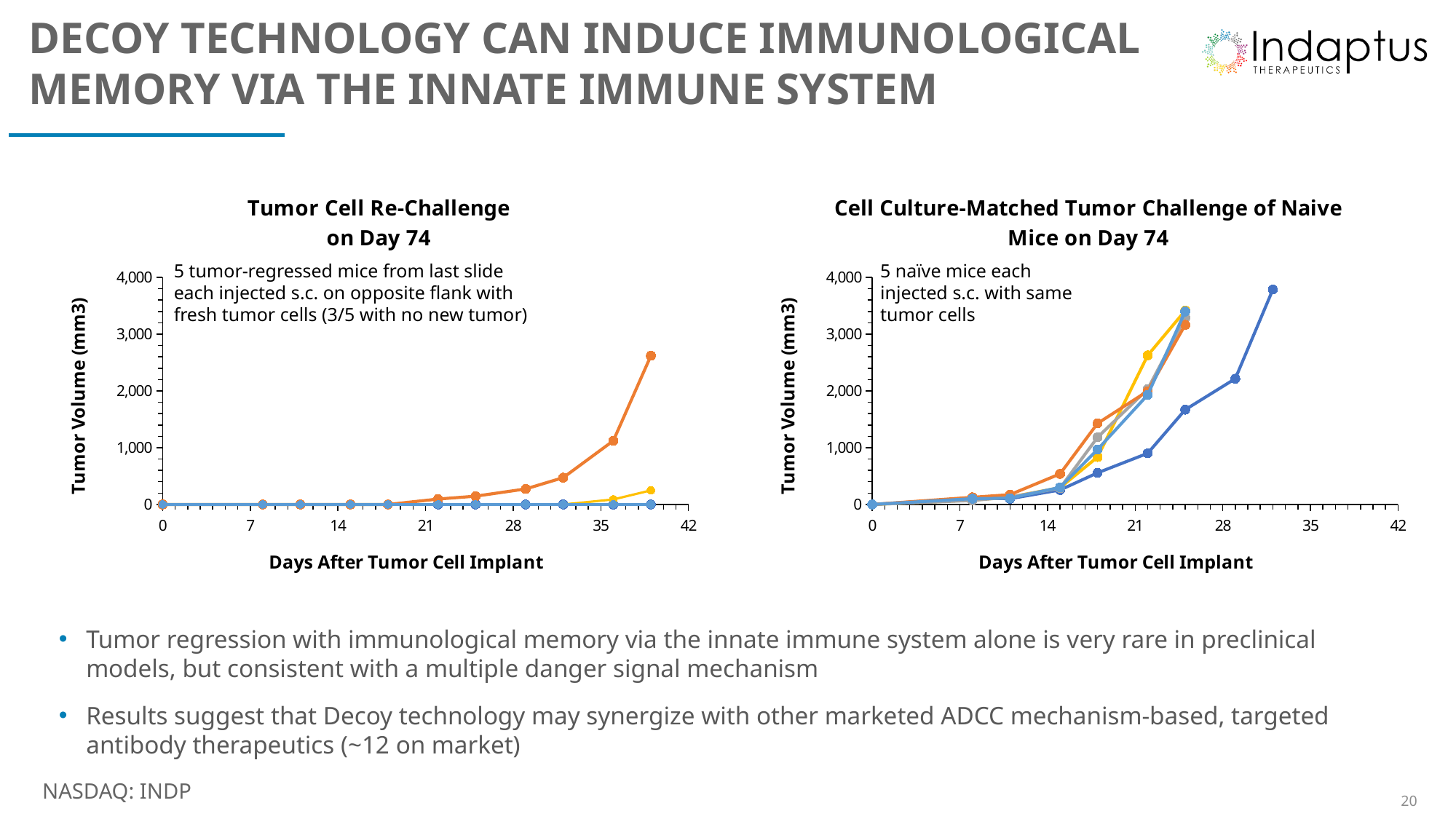
In the 'Tumor Cell Re-Challenge on Day 74' chart, which line has the larger final value, the orange line or the yellow line? orange In the 'Cell Culture-Matched Tumor Challenge of Naive Mice on Day 74' chart, are all the lines greater or less than 1,000 at day 14? less What kind of chart is the 'Cell Culture-Matched Tumor Challenge of Naive Mice on Day 74' chart? line chart In the 'Cell Culture-Matched Tumor Challenge of Naive Mice on Day 74' chart, what is the label of the x axis? Days After Tumor Cell Implant What is the highest tick value shown on the y axis of the 'Cell Culture-Matched Tumor Challenge of Naive Mice on Day 74' chart? 4,000 In the 'Cell Culture-Matched Tumor Challenge of Naive Mice on Day 74' chart, is the final value of the dark blue line greater or less than 3,000? greater What kind of chart is the 'Tumor Cell Re-Challenge on Day 74' chart? line chart In the 'Tumor Cell Re-Challenge on Day 74' chart, is the final value of the orange line greater or less than 2,000? greater In the 'Tumor Cell Re-Challenge on Day 74' chart, what is the label of the y axis? Tumor Volume (mm3) In the 'Tumor Cell Re-Challenge on Day 74' chart, which coloured line reaches the highest tumor volume? orange In the 'Cell Culture-Matched Tumor Challenge of Naive Mice on Day 74' chart, do the tumor volumes rise or fall as days increase? rise